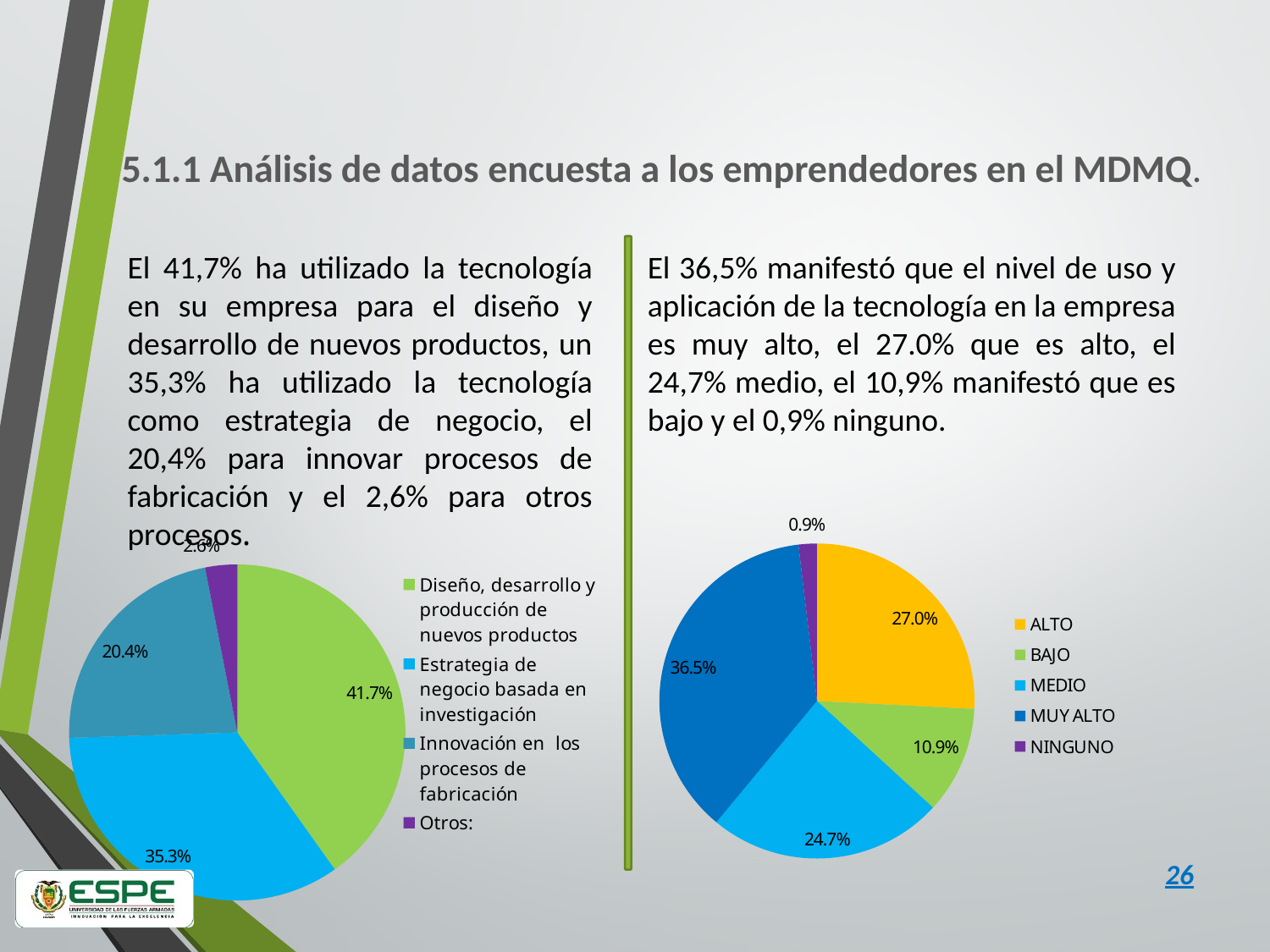
In the left pie chart, how many categories does the legend list? 4 In the right pie chart, how many categories does the legend list? 5 In the left pie chart, which category has the smallest slice? Otros: In the left pie chart, what is the difference between the 'Estrategia de negocio basada en investigación' slice and the 'Innovación en los procesos de fabricación' slice? 14.9% In the left pie chart, what share is labelled for 'Diseño, desarrollo y producción de nuevos productos'? 41.7% In the right pie chart, what share is labelled for MEDIO? 24.7% In the left pie chart, which category has the largest slice? Diseño, desarrollo y producción de nuevos productos In the right pie chart, what share is labelled for MUY ALTO? 36.5% What type of chart is the right chart on the slide? Pie chart In the right pie chart, which category has the smallest slice? NINGUNO In the right pie chart, which is larger, ALTO or BAJO? ALTO In the left pie chart, what share is labelled for 'Otros:'? 2.6%